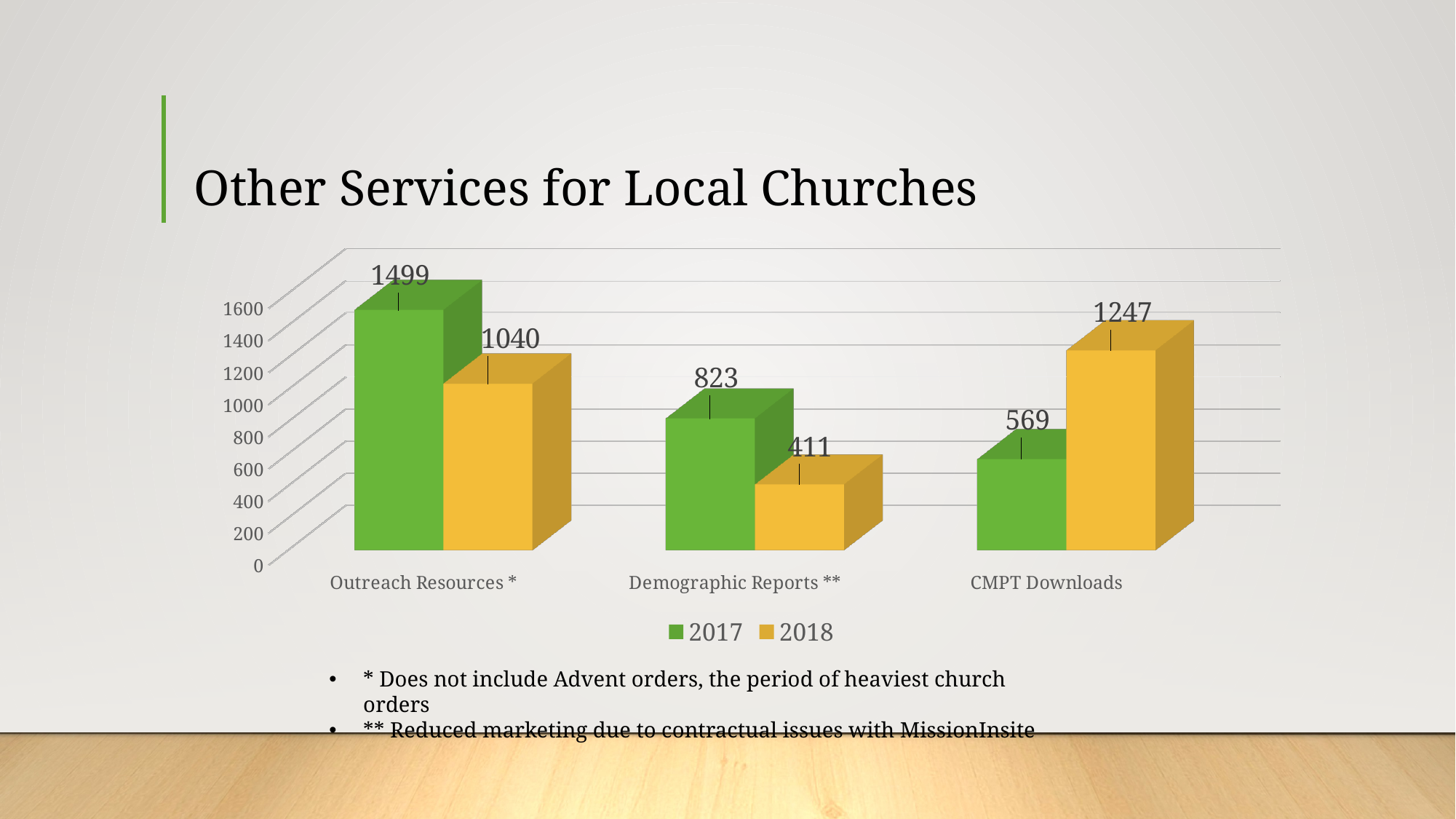
For Demographic Reports **, which year has the larger value, 2017 or 2018? 2017 How many series does the legend list? 2 What is the 2018 value for CMPT Downloads? 1247 Which category has the lowest 2018 value? Demographic Reports ** What is the difference between the 2017 and 2018 values for Outreach Resources *? 459 What is the 2017 value for Outreach Resources *? 1499 What is the 2017 value for CMPT Downloads? 569 How many categories are shown on the x axis? 3 What kind of chart is shown on the slide? Bar chart Which category has the highest 2017 value? Outreach Resources * What is the difference between the 2018 and 2017 values for CMPT Downloads? 678 What is the 2018 value for Demographic Reports **? 411